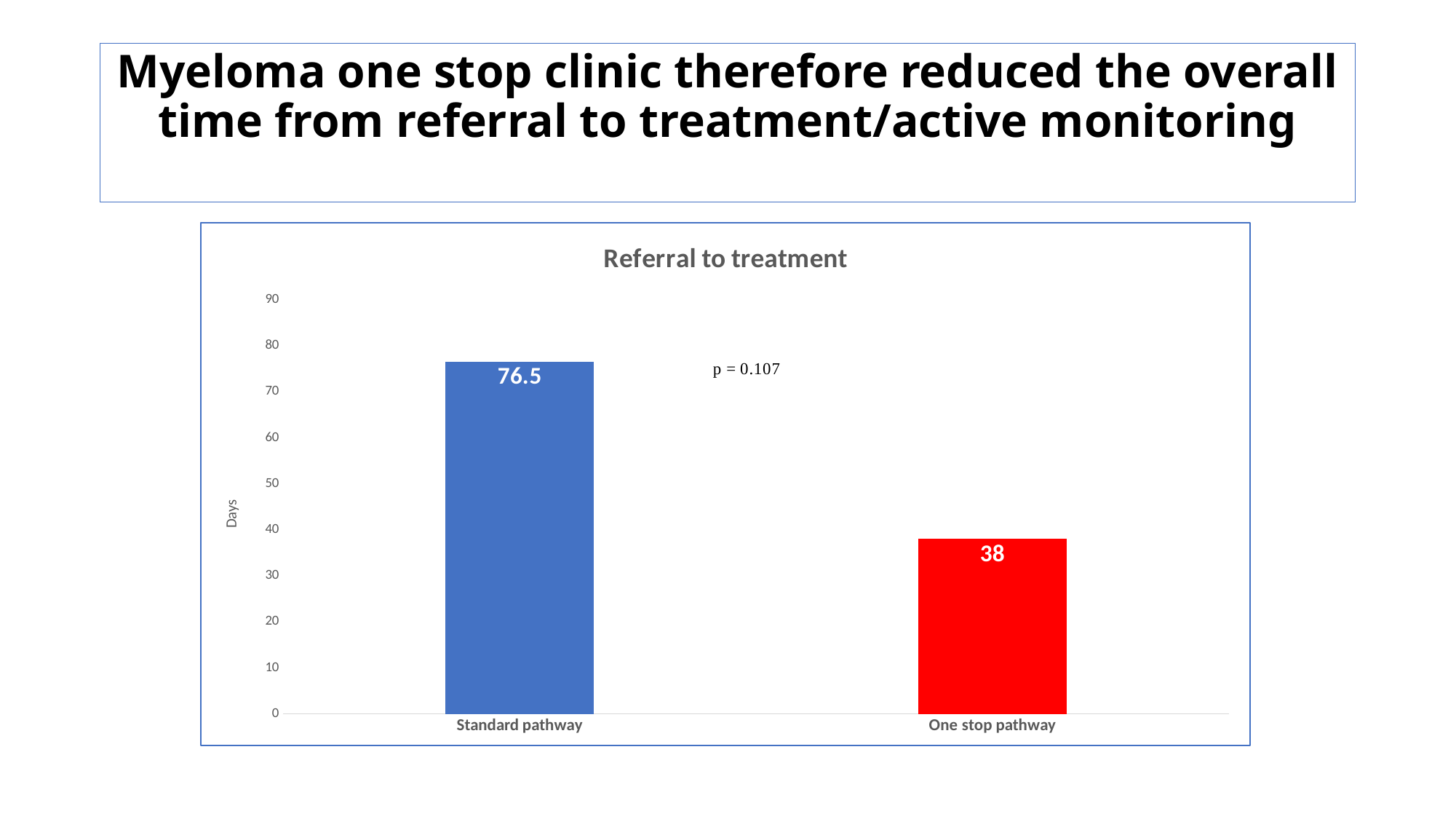
Which is larger, the value for Standard pathway or One stop pathway? Standard pathway Which category has the lowest value? One stop pathway What is the value for One stop pathway? 38 What is the value for Standard pathway? 76.5 Is the value for One stop pathway greater or less than 40? less Is the value for Standard pathway greater or less than 70? greater How many categories are shown on the chart? 2 What is the label on the vertical axis? Days What kind of chart is shown? bar chart What is the title of the chart? Referral to treatment What is the difference between the Standard pathway and One stop pathway values? 38.5 Which category has the highest value? Standard pathway